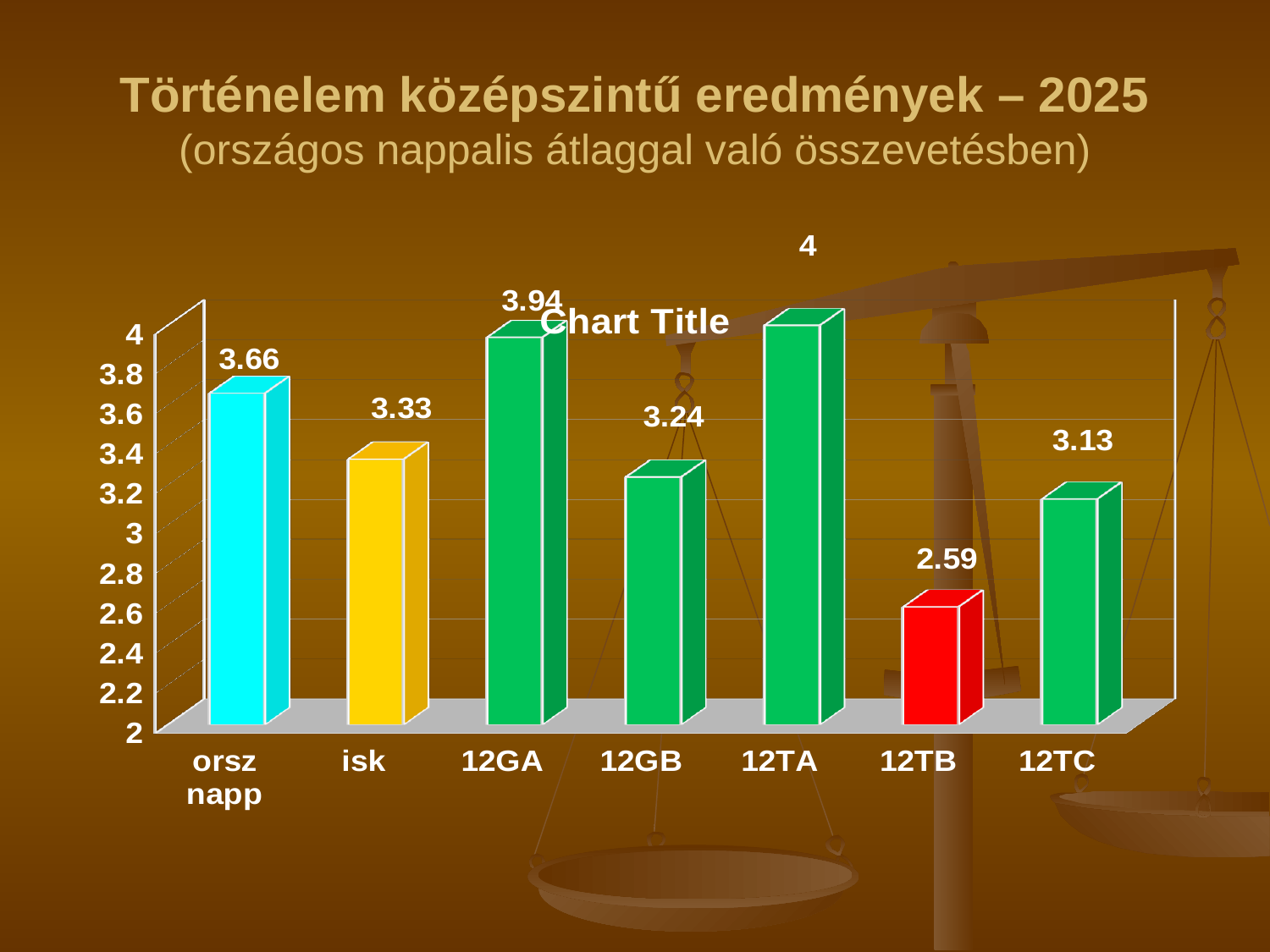
What colour is the bar for 12TB? red What is the value for 12TB? 2.59 Which category has the highest value? 12TA What is the value for isk? 3.33 What is the difference between the values for 12GA and 12GB? 0.7 How many categories are shown on the x axis? 7 Which is larger, the value for 12TC or the value for isk? isk What is the value for 12TA? 4 Which category has the lowest value? 12TB Is the value for 12TB greater or less than 3? less What kind of chart is shown on the slide? bar chart What is the value for orsz napp? 3.66